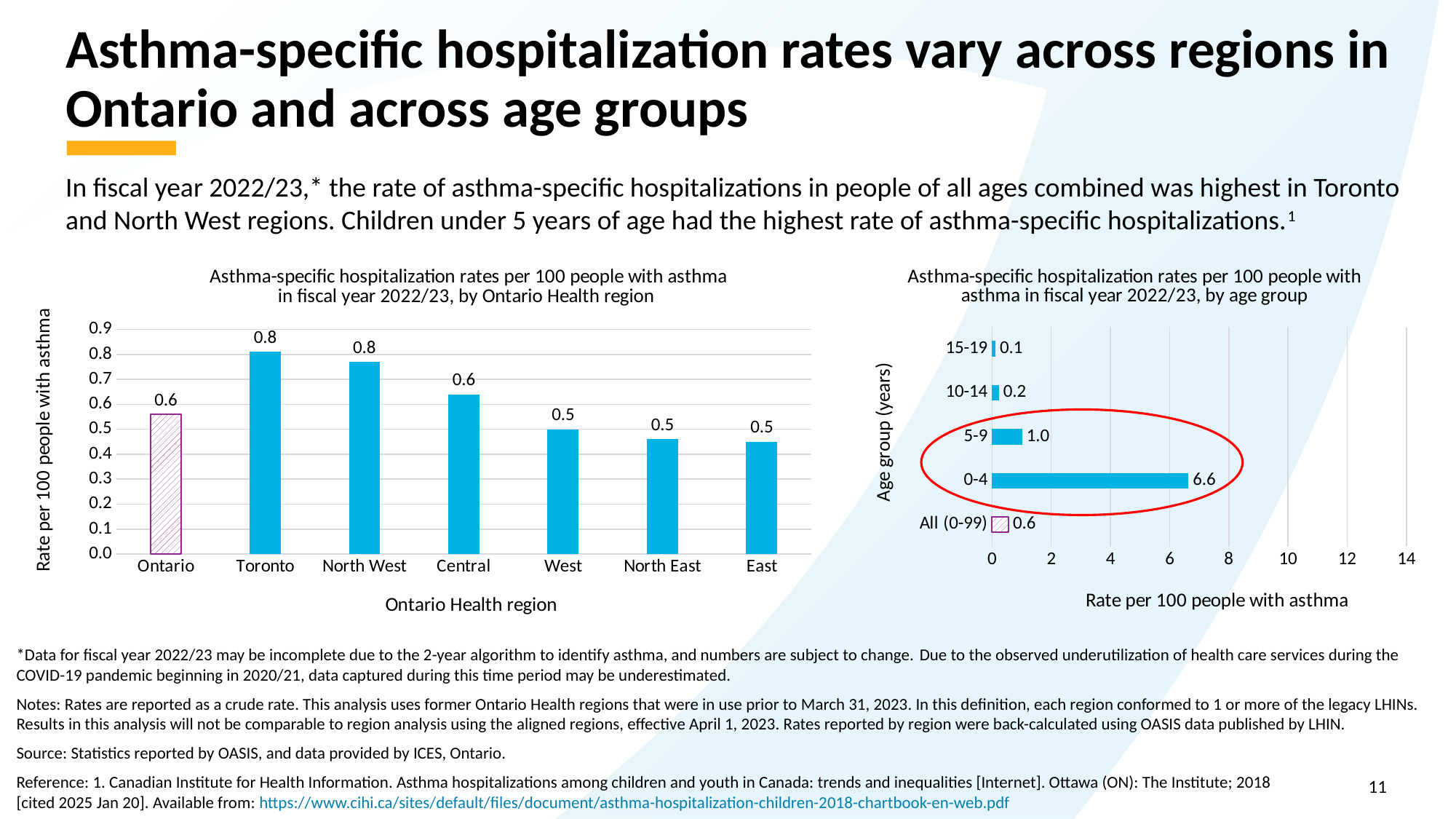
In the chart by Ontario Health region, how many regions (categories) are shown on the x axis? 7 In the chart by Ontario Health region, what is the difference between the rate for Toronto and the rate for North East? 0.3 What kind of chart is the chart by age group? Bar chart In the chart by age group, what is the difference between the rate for the 0-4 age group and the 5-9 age group? 5.6 In the chart by Ontario Health region, what is the rate per 100 people with asthma for West? 0.5 In the chart by Ontario Health region, is the value for Toronto greater or less than 0.7? greater In the chart by age group, how many age group categories are shown? 5 In the chart by age group, what is the rate per 100 people with asthma for the 5-9 age group? 1.0 In the chart by Ontario Health region, what is the rate per 100 people with asthma for Central? 0.6 In the chart by age group, which age group has the lowest hospitalization rate? 15-19 In the chart by age group, which age group has the highest hospitalization rate? 0-4 In the chart by Ontario Health region, which is larger, the rate for Toronto or the rate for East? Toronto